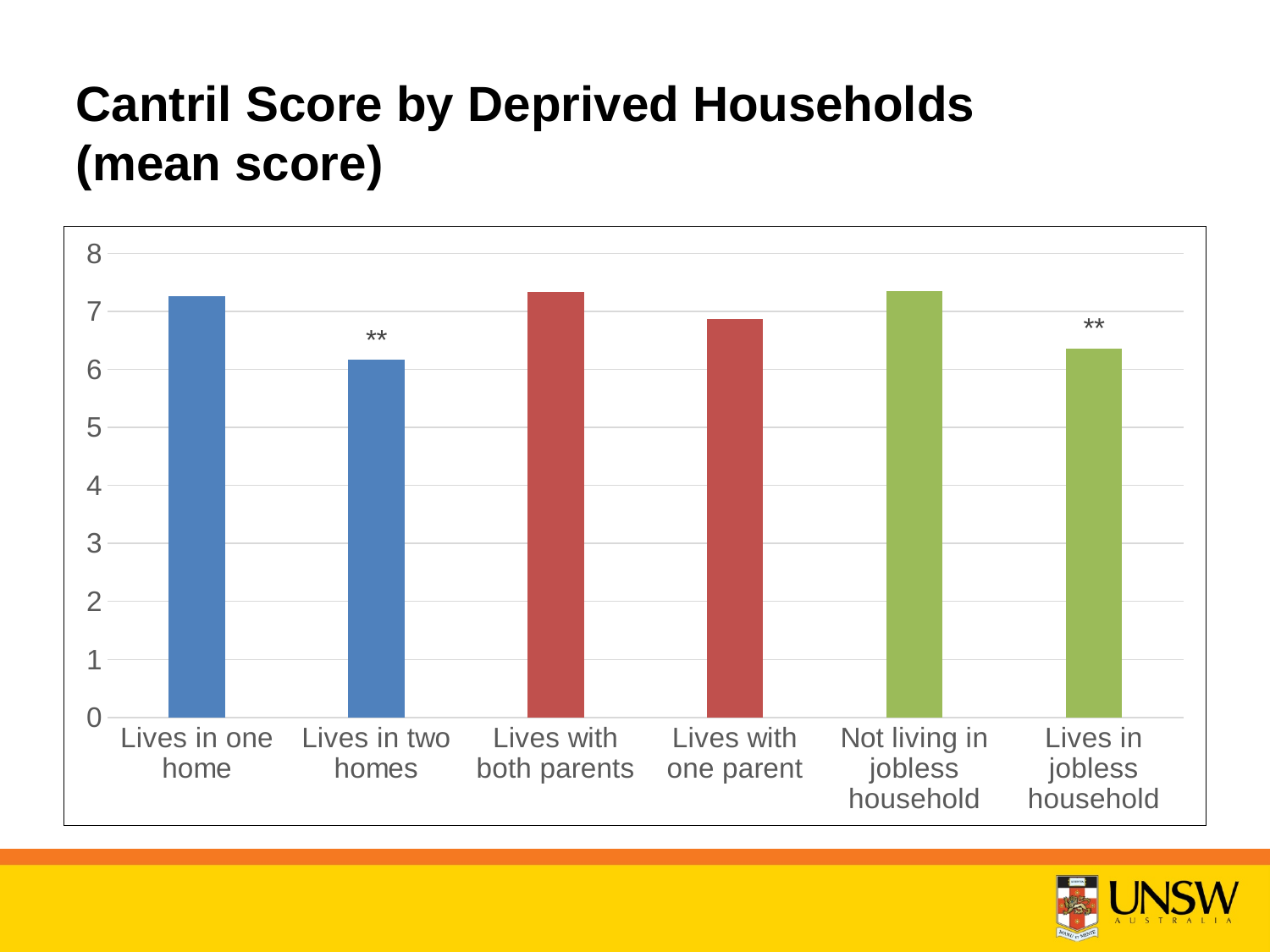
What is the title of the chart on the slide? Cantril Score by Deprived Households (mean score) Is the value for 'Lives in one home' greater or less than 7? greater Which is larger, the mean score for 'Not living in jobless household' or 'Lives in jobless household'? Not living in jobless household Is the value for 'Lives in two homes' greater or less than 7? less Which category has the lowest mean Cantril score? Lives in two homes Which is larger, the mean score for 'Lives in one home' or 'Lives in two homes'? Lives in one home Is the value for 'Lives in jobless household' greater or less than 7? less Which two categories are marked with '**' above their bars? Lives in two homes and Lives in jobless household What kind of chart is shown on the slide? bar chart Which is larger, the mean score for 'Lives with both parents' or 'Lives with one parent'? Lives with both parents How many categories are shown on the x axis of the chart? 6